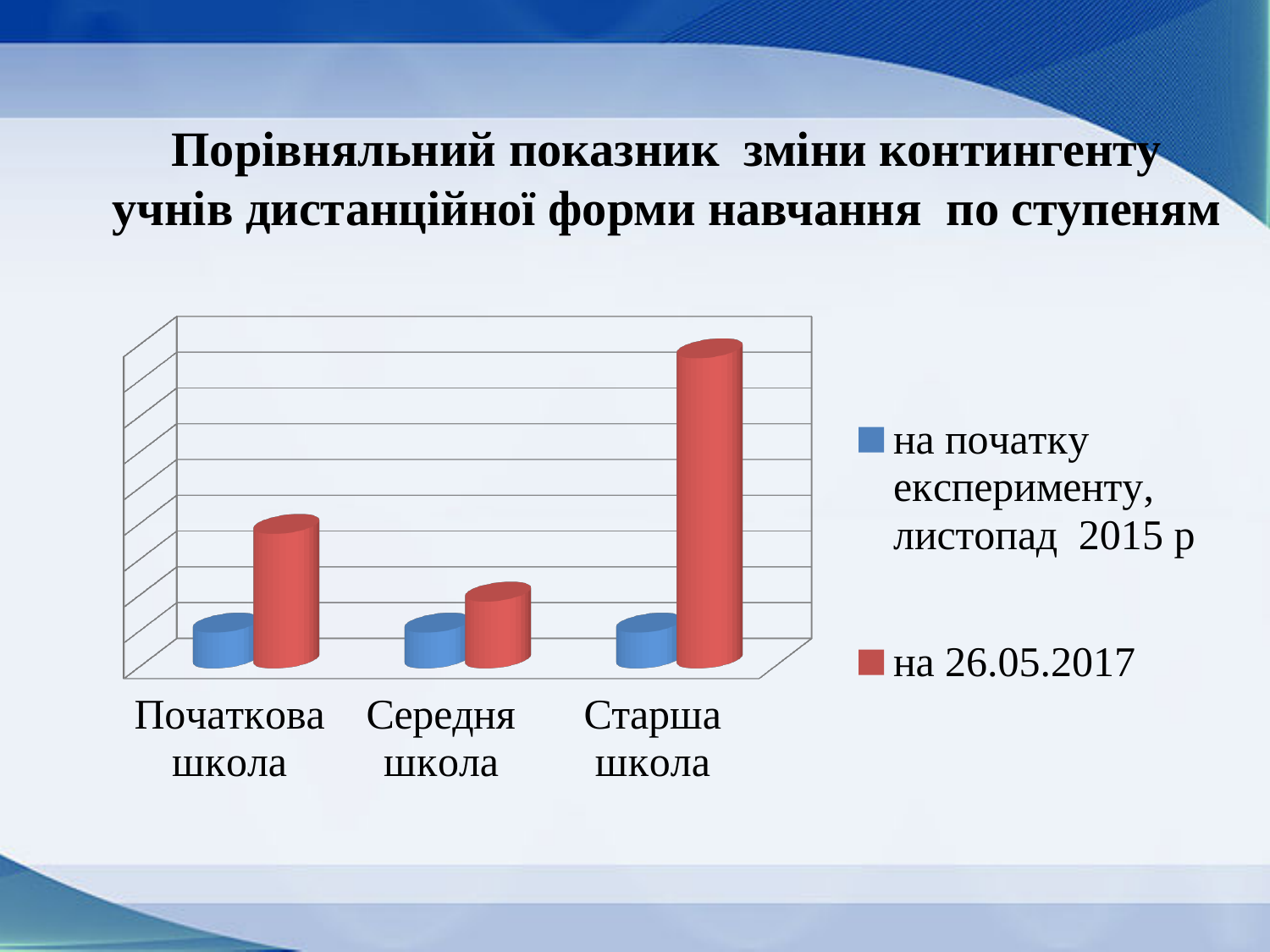
What colour are the bars for the series "на 26.05.2017"? red For Середня школа, which series has the larger value: "на початку експерименту, листопад 2015 р" or "на 26.05.2017"? на 26.05.2017 Which category has the highest value for the series "на 26.05.2017"? Старша школа What is the title of the slide's chart? Порівняльний показник зміни контингенту учнів дистанційної форми навчання по ступеням For Старша школа, which series has the larger value: "на початку експерименту, листопад 2015 р" or "на 26.05.2017"? на 26.05.2017 For Початкова школа, which series has the larger value: "на початку експерименту, листопад 2015 р" or "на 26.05.2017"? на 26.05.2017 What kind of chart is shown on the slide? bar chart Which category has the lowest value for the series "на 26.05.2017"? Середня школа How many series does the chart's legend list? 2 How many categories are shown on the x axis of the chart? 3